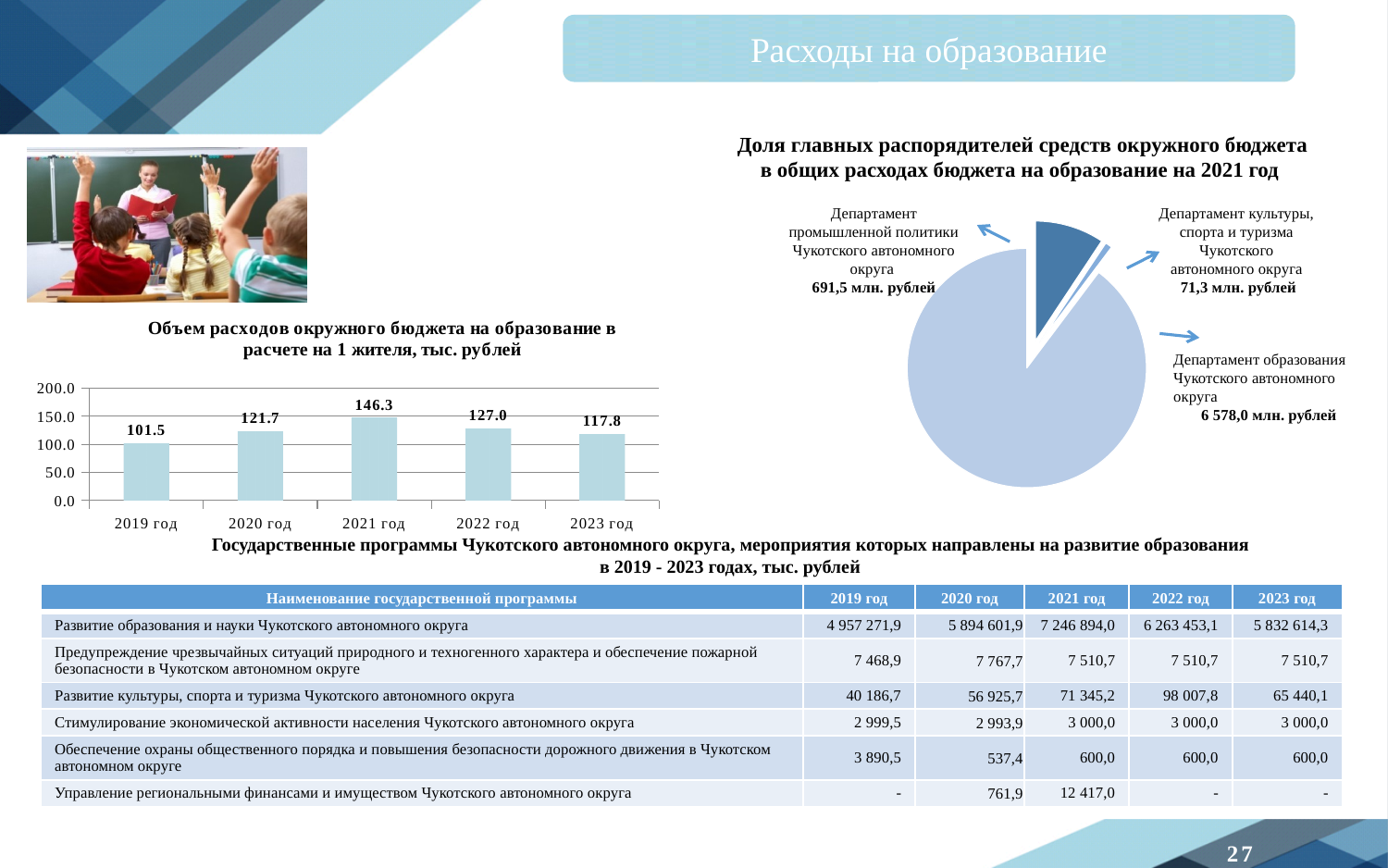
What kind of chart is 'Объем расходов окружного бюджета на образование в расчете на 1 жителя, тыс. рублей'? bar chart In the bar chart 'Объем расходов окружного бюджета на образование в расчете на 1 жителя, тыс. рублей', what is the difference between the values for 2021 год and 2019 год? 44.8 In the bar chart 'Объем расходов окружного бюджета на образование в расчете на 1 жителя, тыс. рублей', what is the value for 2019 год? 101.5 In the bar chart 'Объем расходов окружного бюджета на образование в расчете на 1 жителя, тыс. рублей', do the values rise or fall from 2019 год to 2021 год? rise In the pie chart 'Доля главных распорядителей средств окружного бюджета в общих расходах бюджета на образование на 2021 год', what is the value for Департамент культуры, спорта и туризма Чукотского автономного округа? 71,3 млн. рублей In the bar chart 'Объем расходов окружного бюджета на образование в расчете на 1 жителя, тыс. рублей', which year has the lowest value? 2019 год In the bar chart 'Объем расходов окружного бюджета на образование в расчете на 1 жителя, тыс. рублей', which is larger: the value for 2020 год or 2023 год? 2020 год In the bar chart 'Объем расходов окружного бюджета на образование в расчете на 1 жителя, тыс. рублей', which year has the highest value? 2021 год In the pie chart 'Доля главных распорядителей средств окружного бюджета в общих расходах бюджета на образование на 2021 год', which department has the largest slice? Департамент образования Чукотского автономного округа In the bar chart 'Объем расходов окружного бюджета на образование в расчете на 1 жителя, тыс. рублей', what is the value for 2021 год? 146.3 In the bar chart 'Объем расходов окружного бюджета на образование в расчете на 1 жителя, тыс. рублей', how many years are shown? 5